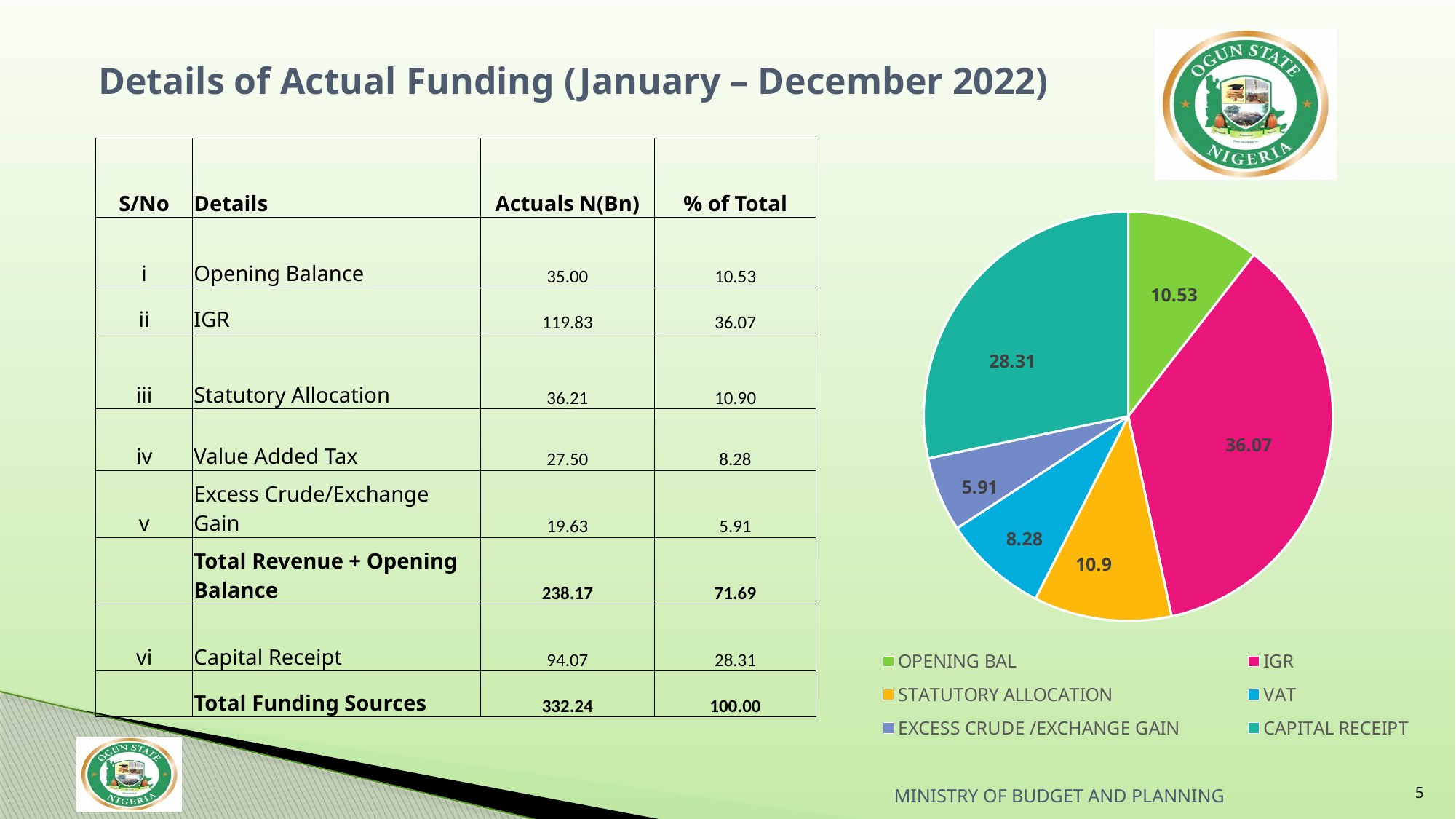
Which slice of the pie chart is the smallest? Excess Crude/Exchange Gain How many slices does the pie chart have? 6 Which slice of the pie chart is the largest? IGR What is the value shown for IGR in the pie chart? 36.07 In the pie chart, which is larger: VAT or Opening Bal? Opening Bal What is the difference between the IGR and Capital Receipt values in the pie chart? 7.76 What is the value shown for Statutory Allocation in the pie chart? 10.9 How many entries does the pie chart's legend list? 6 What kind of chart is shown on the slide? pie chart What is the value shown for Capital Receipt in the pie chart? 28.31 What is the value shown for Excess Crude/Exchange Gain in the pie chart? 5.91 What colour is the IGR slice in the pie chart? pink